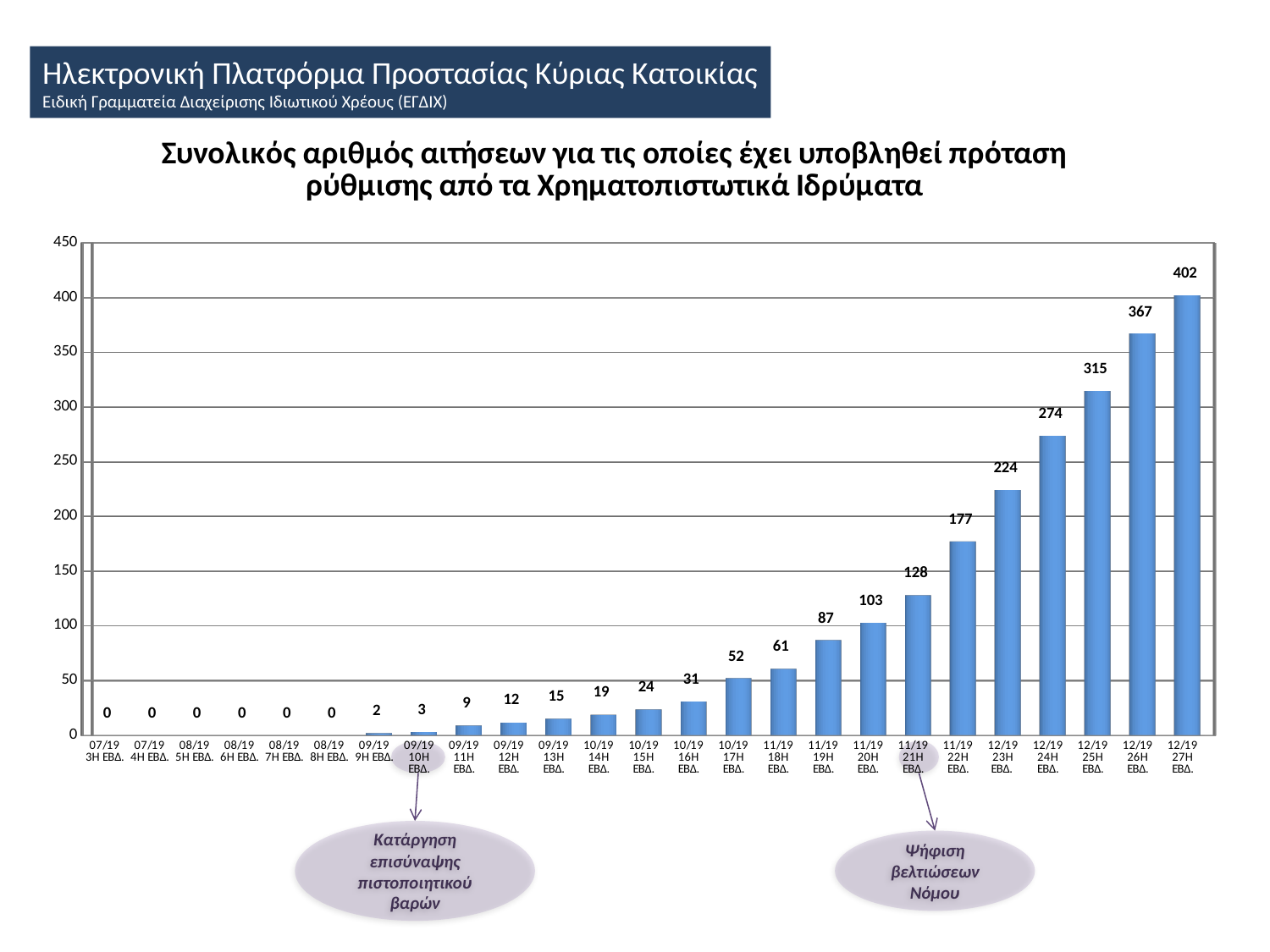
How many categories (weeks) are shown on the x axis? 25 What is the value for 09/19 10H ΕΒΔ.? 3 What is the value for 10/19 17H ΕΒΔ.? 52 Which is larger, the value for 12/19 24H ΕΒΔ. or the value for 12/19 23H ΕΒΔ.? 12/19 24H ΕΒΔ. Is the value for 12/19 25H ΕΒΔ. greater or less than 300? greater What type of chart is shown on the slide? bar chart Do the values rise or fall along the x axis from left to right? rise What is the difference between the values for 11/19 22H ΕΒΔ. and 11/19 21H ΕΒΔ.? 49 What is the value for 11/19 21H ΕΒΔ.? 128 What is the value for 12/19 27H ΕΒΔ.? 402 Which category has the highest value? 12/19 27H ΕΒΔ. What is the difference between the values for 12/19 27H ΕΒΔ. and 12/19 26H ΕΒΔ.? 35